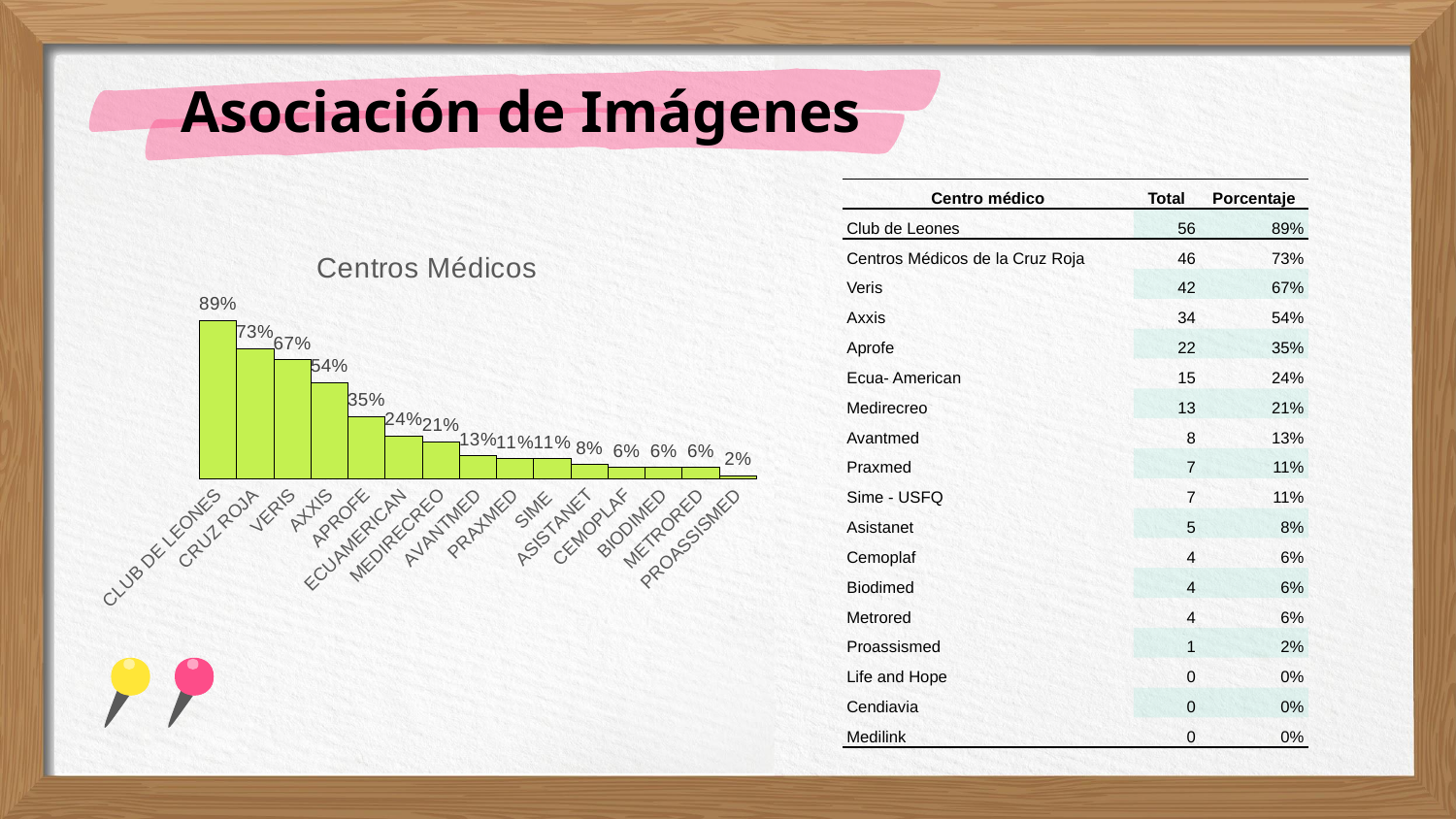
What is the difference between the values for CLUB DE LEONES and CRUZ ROJA in the Centros Médicos chart? 16% What is the difference between the values for AXXIS and APROFE in the Centros Médicos chart? 19% What is the value for ASISTANET in the Centros Médicos chart? 8% Do the values in the Centros Médicos chart rise or fall from left to right along the x axis? Fall What kind of chart is the Centros Médicos chart? Bar chart What is the value for CLUB DE LEONES in the Centros Médicos chart? 89% Which category has the lowest value in the Centros Médicos chart? PROASSISMED How many categories are shown in the Centros Médicos chart? 15 Which category has the highest value in the Centros Médicos chart? CLUB DE LEONES What is the value for MEDIRECREO in the Centros Médicos chart? 21% Which has a larger value in the Centros Médicos chart, VERIS or ECUAMERICAN? VERIS What is the value for APROFE in the Centros Médicos chart? 35%